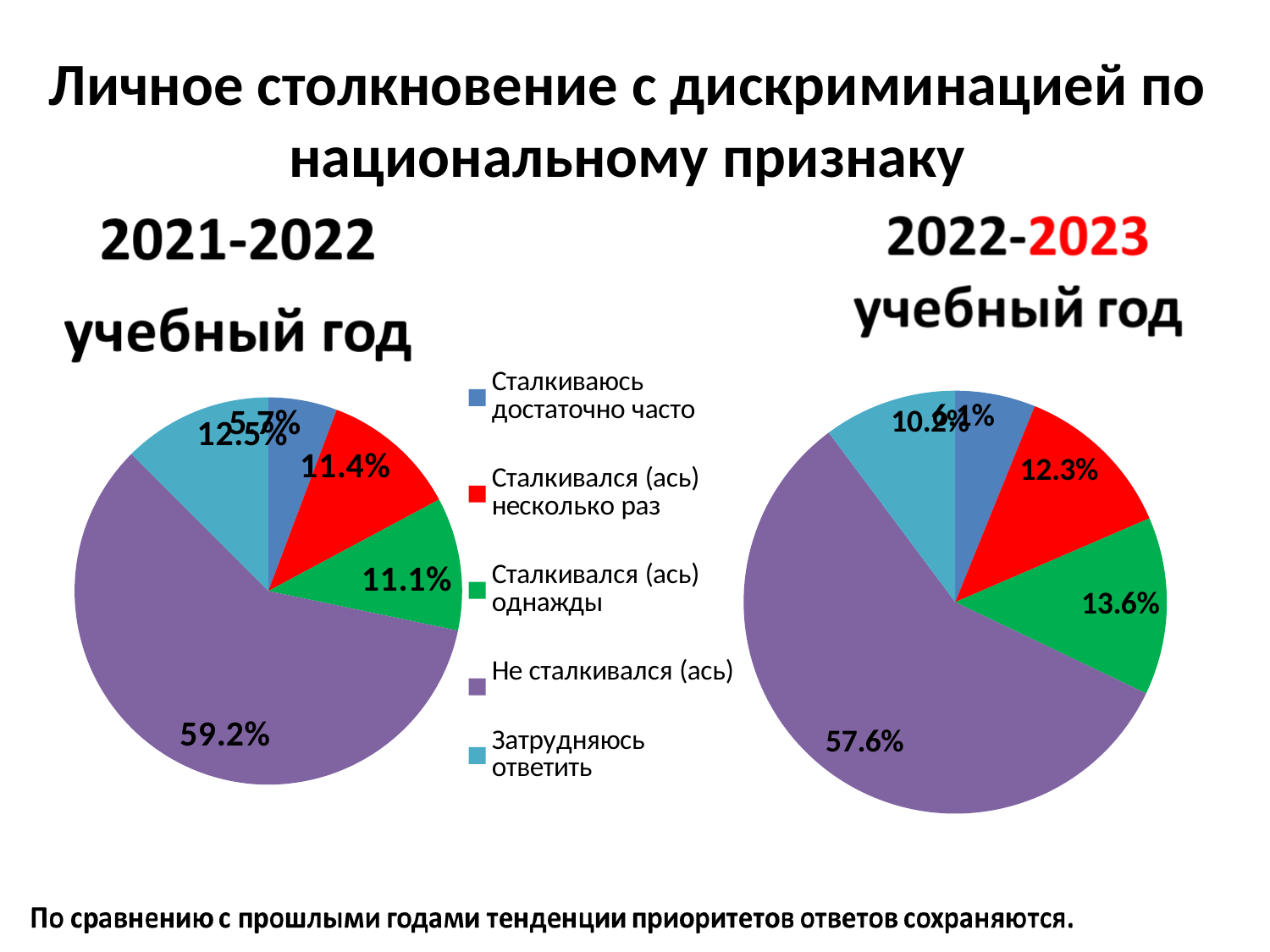
Which colour represents "Затрудняюсь ответить" in the legend? Teal (light blue) Which chart shows a larger share for "Сталкивался (ась) однажды": 2021-2022 or 2022-2023? 2022-2023 In the 2022-2023 учебный год pie chart, what share of respondents answered "Сталкивался (ась) однажды"? 13.6% In the 2021-2022 учебный год pie chart, what share of respondents answered "Не сталкивался (ась)"? 59.2% In the 2022-2023 учебный год pie chart, which answer has the largest share? Не сталкивался (ась) What is the difference between the "Не сталкивался (ась)" share in the 2021-2022 chart and in the 2022-2023 chart? 1.6% What type of chart is used for the 2021-2022 учебный год data? Pie chart In the 2022-2023 учебный год pie chart, what share of respondents answered "Сталкивался (ась) несколько раз"? 12.3% How many categories does each pie chart on the slide contain? 5 In the 2022-2023 учебный год pie chart, what is the difference between the "Сталкивался (ась) однажды" share and the "Сталкиваюсь достаточно часто" share? 7.5% In the 2021-2022 учебный год pie chart, which answer has the smallest share? Сталкиваюсь достаточно часто In the 2021-2022 учебный год pie chart, what share of respondents answered "Сталкивался (ась) несколько раз"? 11.4%